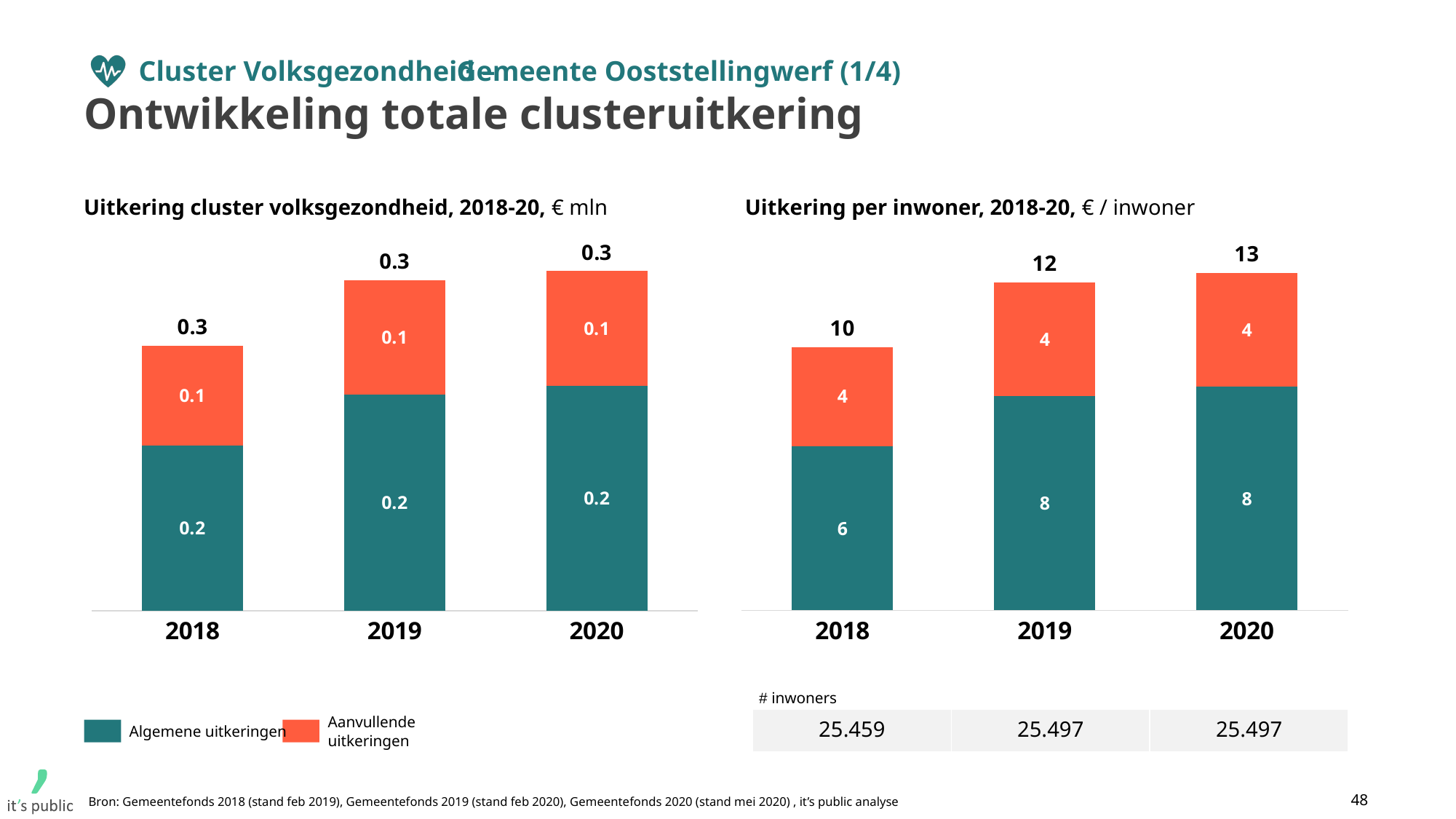
In the chart 'Uitkering cluster volksgezondheid, 2018-20', what is the value of Algemene uitkeringen for 2019? 0.2 In the chart 'Uitkering cluster volksgezondheid, 2018-20', what is the value of Aanvullende uitkeringen for 2020? 0.1 What kind of chart is 'Uitkering cluster volksgezondheid, 2018-20'? stacked bar chart In the chart 'Uitkering cluster volksgezondheid, 2018-20', what is the total of the stacked bar for 2018? 0.3 In the chart 'Uitkering per inwoner, 2018-20', do the totals rise or fall from 2018 to 2020? rise How many years are shown on the x axis of the chart 'Uitkering per inwoner, 2018-20'? 3 In the chart 'Uitkering per inwoner, 2018-20', what is the value of Aanvullende uitkeringen for 2019? 4 In the chart 'Uitkering per inwoner, 2018-20', is the Algemene uitkeringen value for 2019 larger or smaller than for 2018? larger In the chart 'Uitkering per inwoner, 2018-20', which year has the lowest total? 2018 In the chart 'Uitkering per inwoner, 2018-20', what is the value of Algemene uitkeringen for 2018? 6 In the chart 'Uitkering per inwoner, 2018-20', what is the difference between the total for 2020 and the total for 2018? 3 In the chart 'Uitkering per inwoner, 2018-20', which year has the highest total? 2020